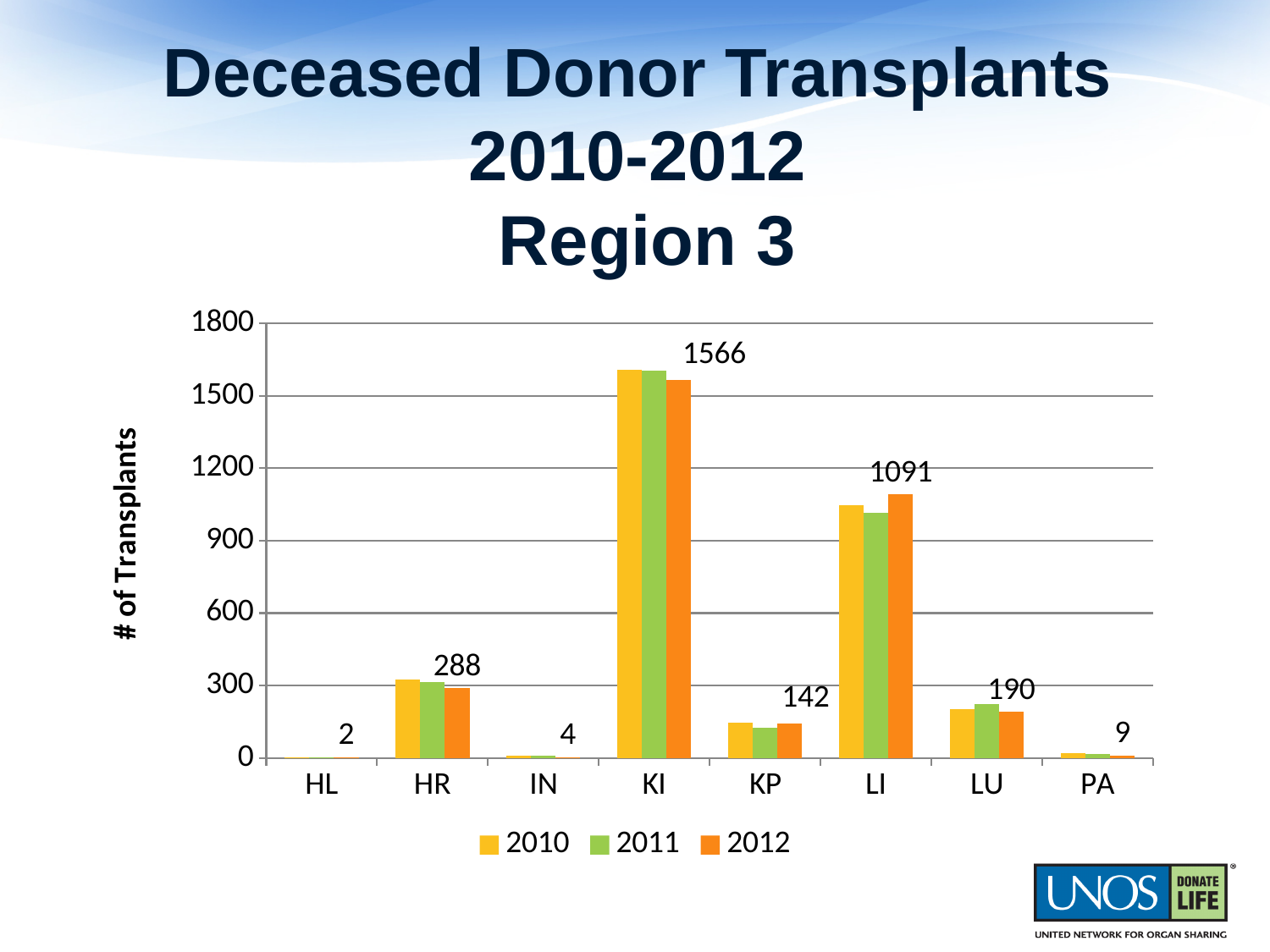
Which organ category has the lowest number of transplants in 2012? HL What kind of chart is shown on the slide? bar chart Which organ category has the highest number of transplants in 2012? KI In 2012, which has more transplants, LU or KP? LU Is the 2010 value for KI greater or less than 1500? greater What is the difference between the 2012 values for HR and LU? 98 What is the 2012 value for LI? 1091 What is the number of deceased donor transplants for KI in 2012? 1566 What is the difference between the 2012 values for KI and LI? 475 How many organ categories are shown on the x axis? 8 What is the 2012 value for HR? 288 How many series does the legend list? 3